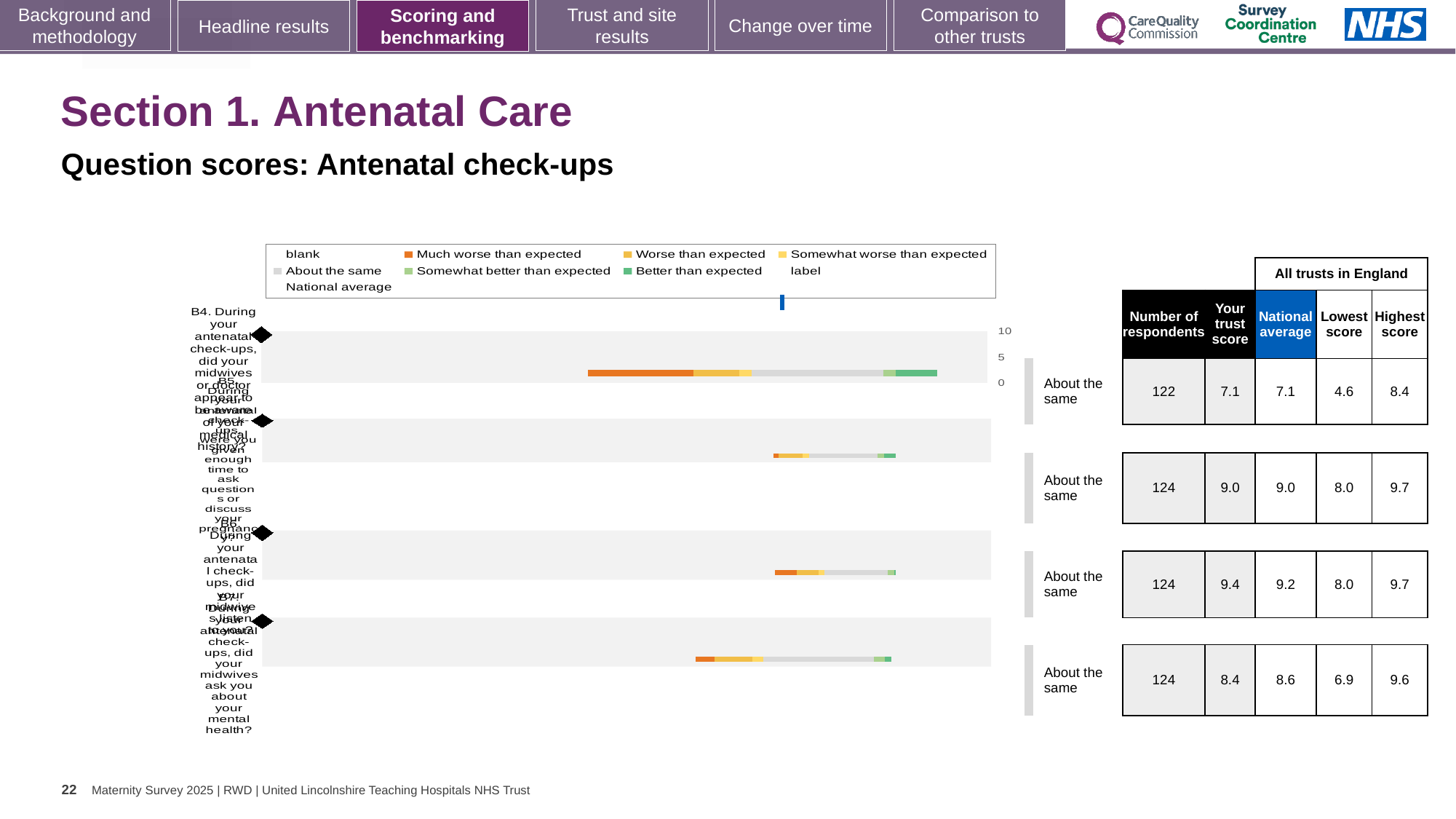
In the chart legend, what does the dark green entry represent? Better than expected For question B7, which is larger: the trust score or the national average? national average In the table beside the chart, what is the trust score for question B5? 9.0 For question B4, what is the difference between the highest score and the lowest score across all trusts in England? 3.8 In the chart legend, which colour represents 'Much worse than expected'? orange In the table beside the chart, what is the lowest score across all trusts in England for question B4? 4.6 In the table beside the chart, which question has the fewest respondents? B4 How many survey questions (bars) are plotted in the chart? 4 What kind of chart is shown on the slide? bar chart In the table beside the chart, which question has the highest trust score? B6 In the table beside the chart, what is the national average for question B7? 8.6 In the table beside the chart, what is the number of respondents for question B4? 122